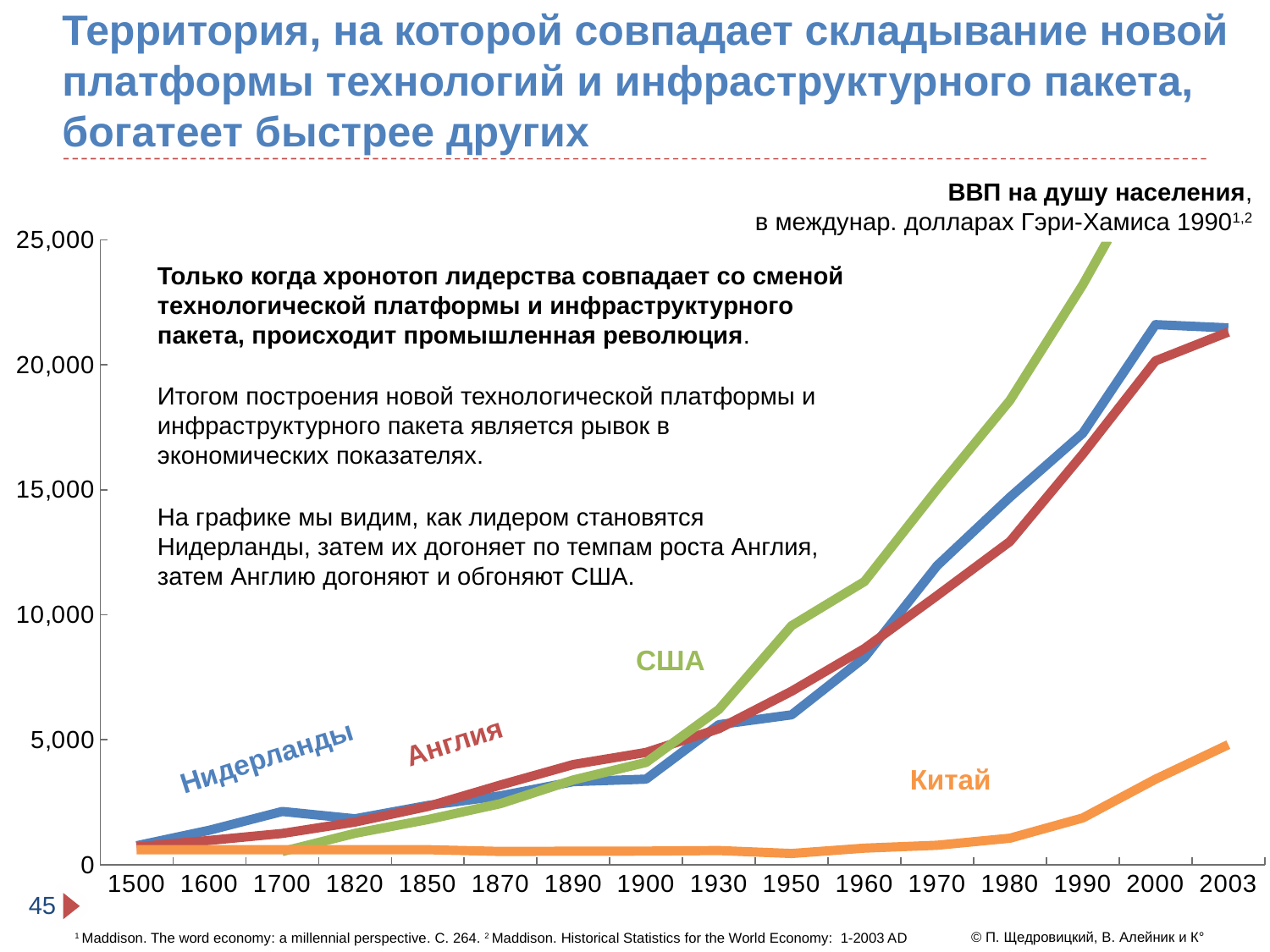
Which country has the lowest GDP per capita in 2003? Китай How many years are marked along the x axis of the chart? 16 Is the value for Китай in 1990 greater or less than 5,000? less Which country has the highest GDP per capita in 1990? США Is the value for Нидерланды in 2000 greater or less than 20,000? greater In 1900, which is larger: the value for Англия or the value for Нидерланды? Англия What kind of chart is shown on the slide? line chart How many series (countries) are plotted on the chart? 4 What colour is the line for Китай? orange In 1950, which is larger: the value for США or the value for Нидерланды? США Does the value for Китай rise or fall from 1980 to 2003? rise Which country has the highest GDP per capita in 1700? Нидерланды